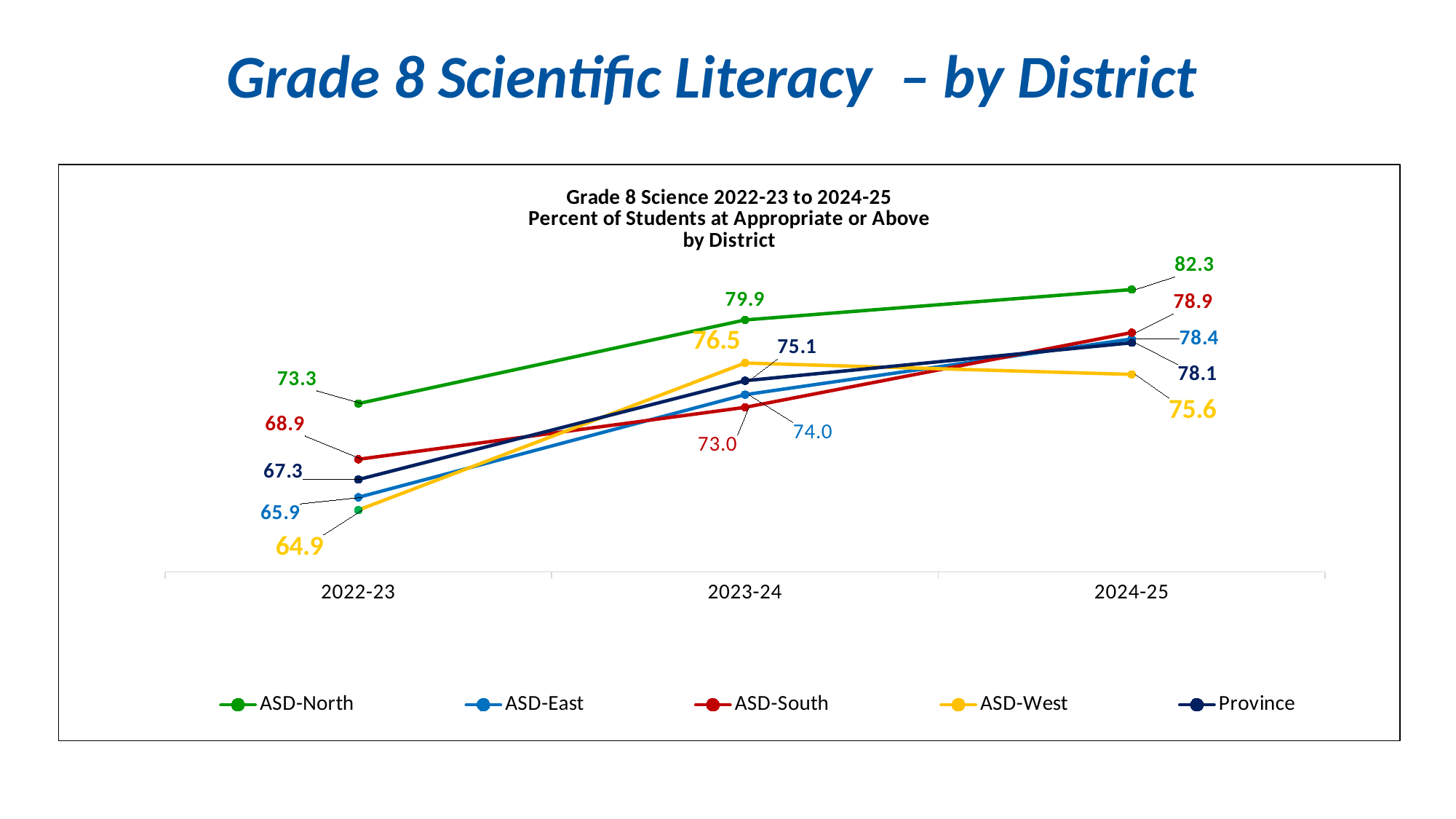
Which series has the lowest value in 2024-25? ASD-West What kind of chart is shown? Line chart What is the value for ASD-West in 2022-23? 64.9 What is the value for ASD-South in 2024-25? 78.9 Which district has the highest value in 2022-23? ASD-North Which is larger in 2023-24, ASD-West or ASD-East? ASD-West How many series does the legend list? 5 Does the ASD-West line rise or fall from 2023-24 to 2024-25? Fall How many time periods are shown on the x axis? 3 What is the value for ASD-North in 2024-25? 82.3 What is the value for Province in 2023-24? 75.1 What is the difference between ASD-North and ASD-West in 2024-25? 6.7